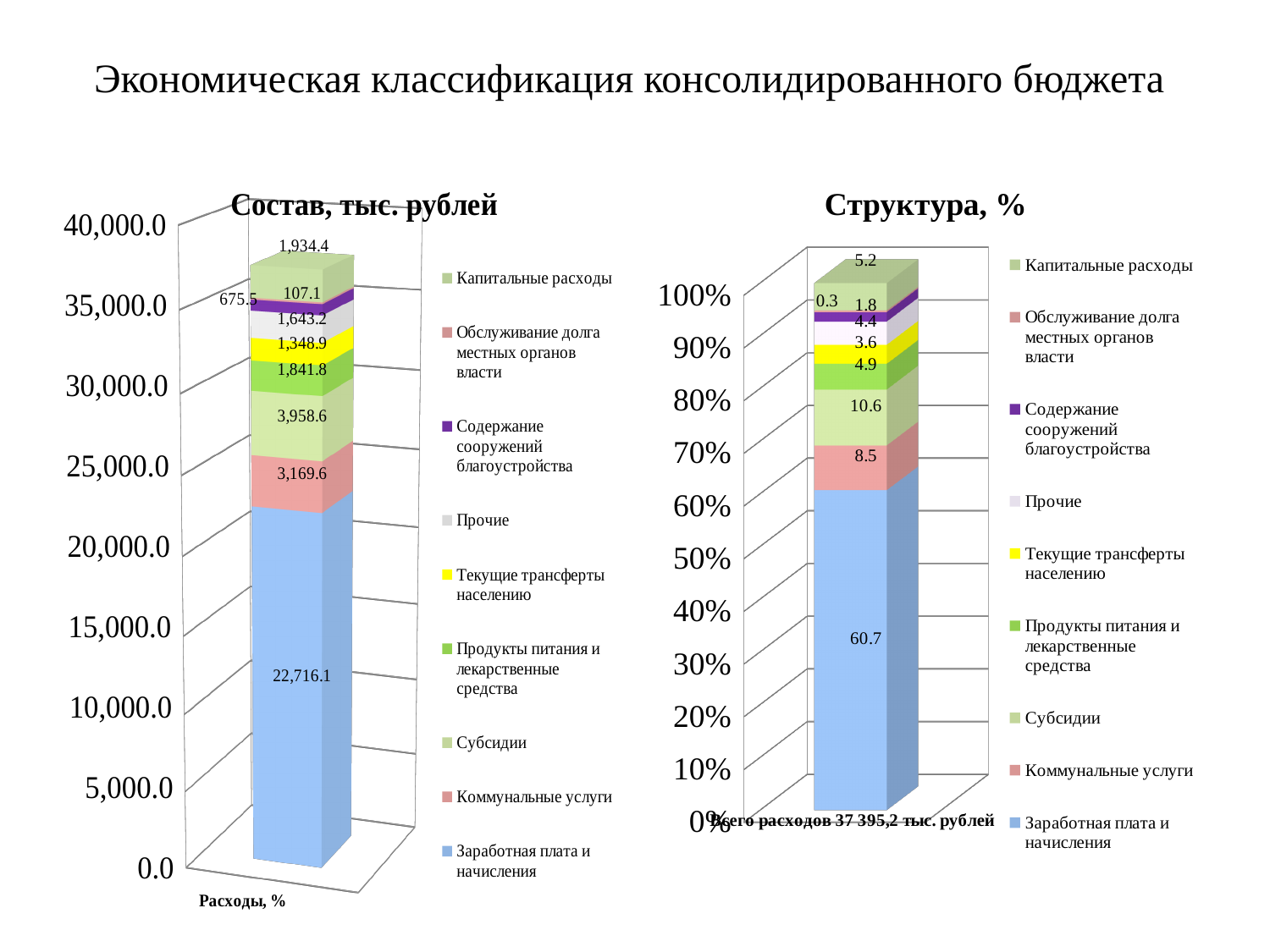
In the chart titled "Состав, тыс. рублей", what is the difference between the values for Субсидии and Коммунальные услуги? 789.0 In the chart titled "Структура, %", which is larger: the value for Продукты питания и лекарственные средства or the value for Текущие трансферты населению? Продукты питания и лекарственные средства In the chart titled "Структура, %", which series has the largest value? Заработная плата и начисления In the chart titled "Структура, %", what is the value for Коммунальные услуги? 8.5 In the chart titled "Структура, %", what is the value for Капитальные расходы? 5.2 How many series does the legend of the chart titled "Структура, %" list? 9 In the chart titled "Состав, тыс. рублей", what is the value for Субсидии? 3,958.6 In the chart titled "Состав, тыс. рублей", what is the value for Заработная плата и начисления? 22,716.1 In the chart titled "Состав, тыс. рублей", what is the total of the stacked bar? 37,395.2 What kind of chart is the chart titled "Состав, тыс. рублей"? Stacked bar chart In the chart titled "Состав, тыс. рублей", is the top of the stacked bar greater or less than 35,000.0? greater In the chart titled "Состав, тыс. рублей", which series has the smallest value? Обслуживание долга местных органов власти